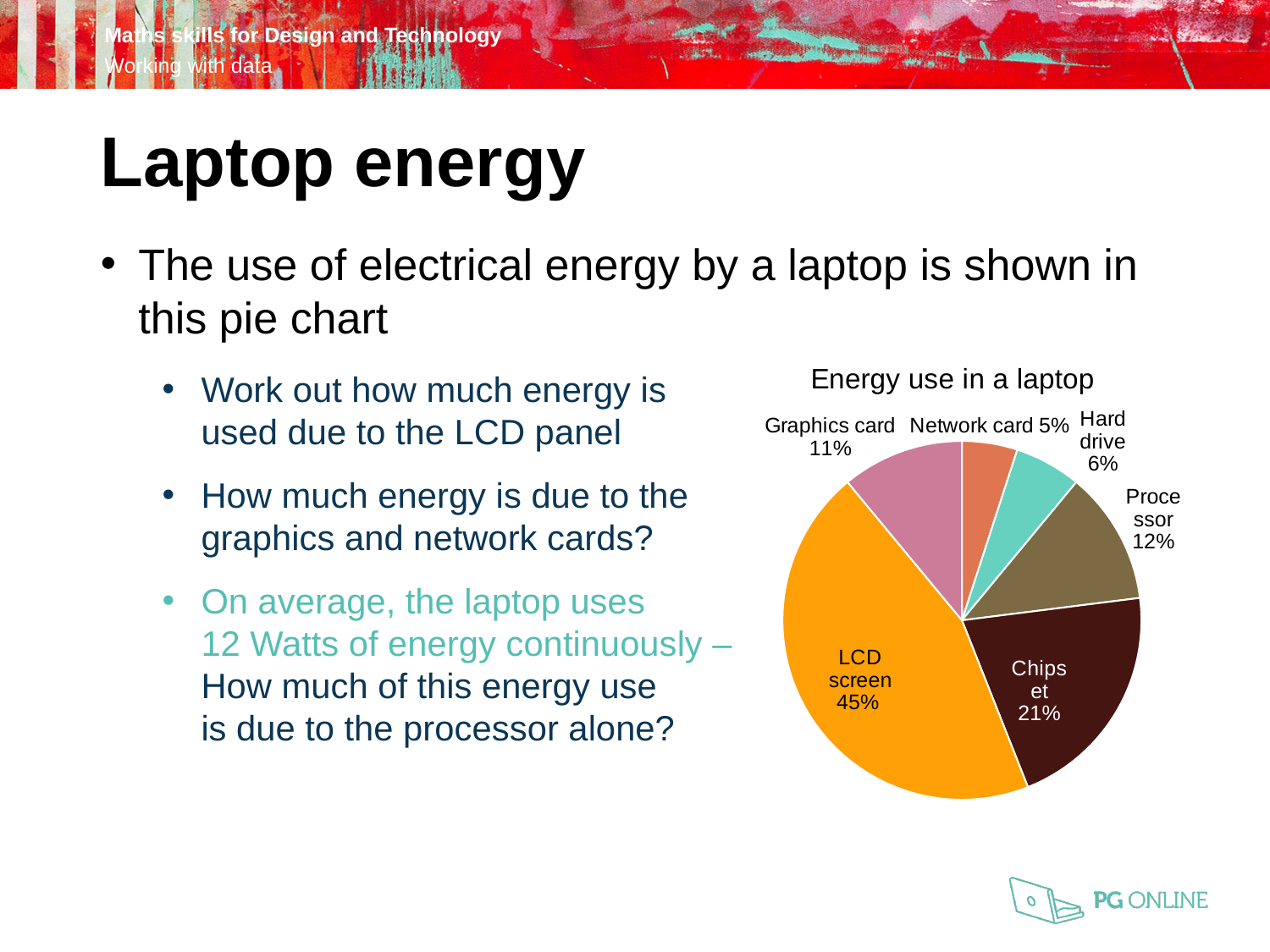
What type of chart is shown on the slide? pie chart What percentage of energy use is due to the Processor? 12% What is the title of the chart? Energy use in a laptop What percentage of energy use is due to the Network card? 5% What is the combined share of the Graphics card and the Network card? 16% Which has a larger share of energy use, the Graphics card or the Hard drive? Graphics card Which category has the smallest share of energy use? Network card What percentage of energy use is due to the LCD screen? 45% How many categories are shown in the pie chart? 6 Which category has the largest share of energy use? LCD screen What percentage of energy use is due to the Chipset? 21% What is the difference in percentage points between the LCD screen and the Chipset? 24